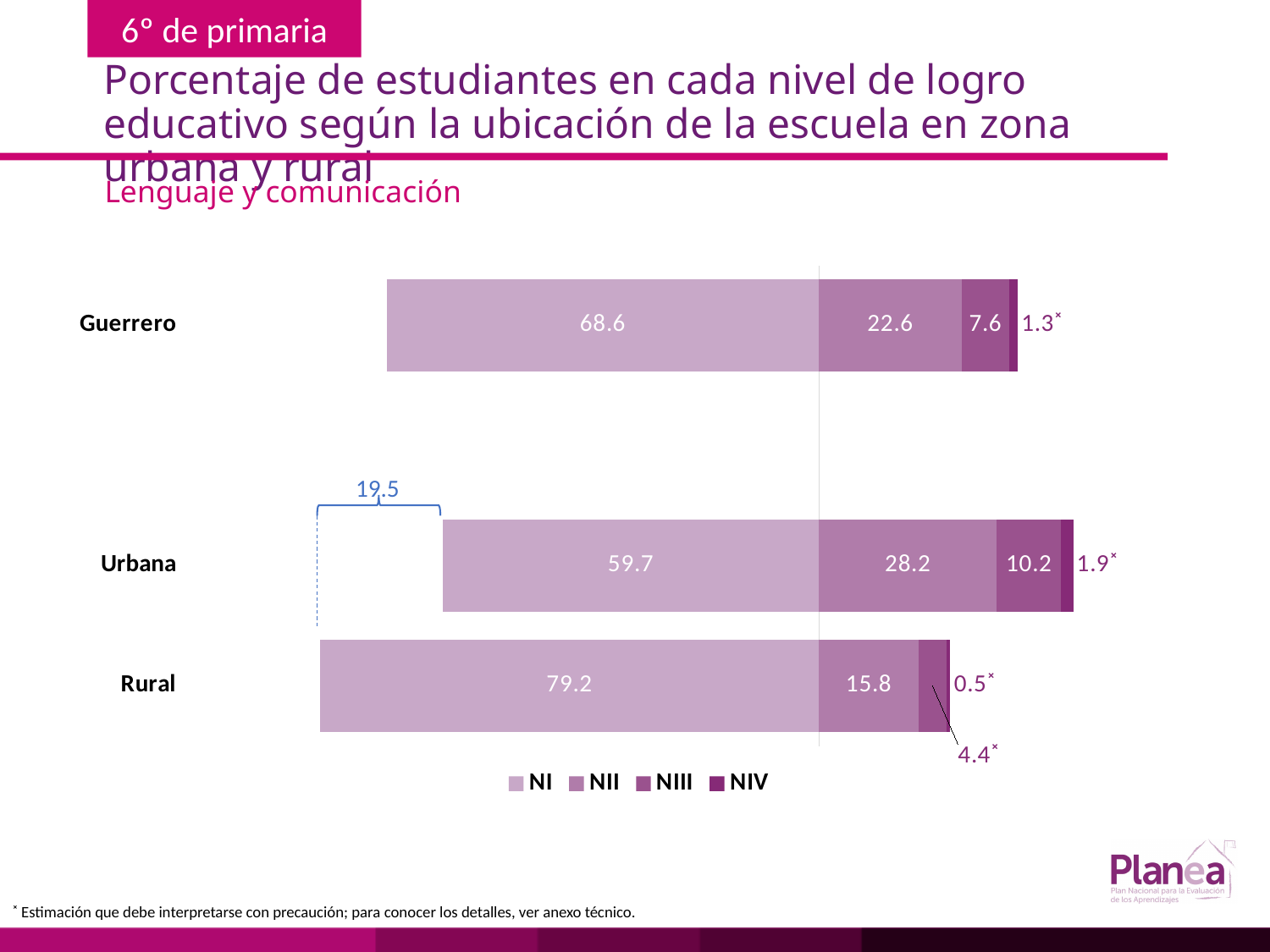
What is the difference between the NI values for Rural and Urbana? 19.5 How many categories (bars) are plotted in the chart? 3 What is the NIII value for Rural? 4.4 Which is larger, the NIII value for Urbana or the NIII value for Guerrero? Urbana What is the NI value for Guerrero? 68.6 How many series does the legend list? 4 Which category has the lowest NIV value? Rural What type of chart is shown on the slide? Stacked bar chart Which category has the highest NI value? Rural What is the NII value for Urbana? 28.2 What is the NIV value for Urbana? 1.9 What are the legend entries of the chart? NI, NII, NIII, NIV